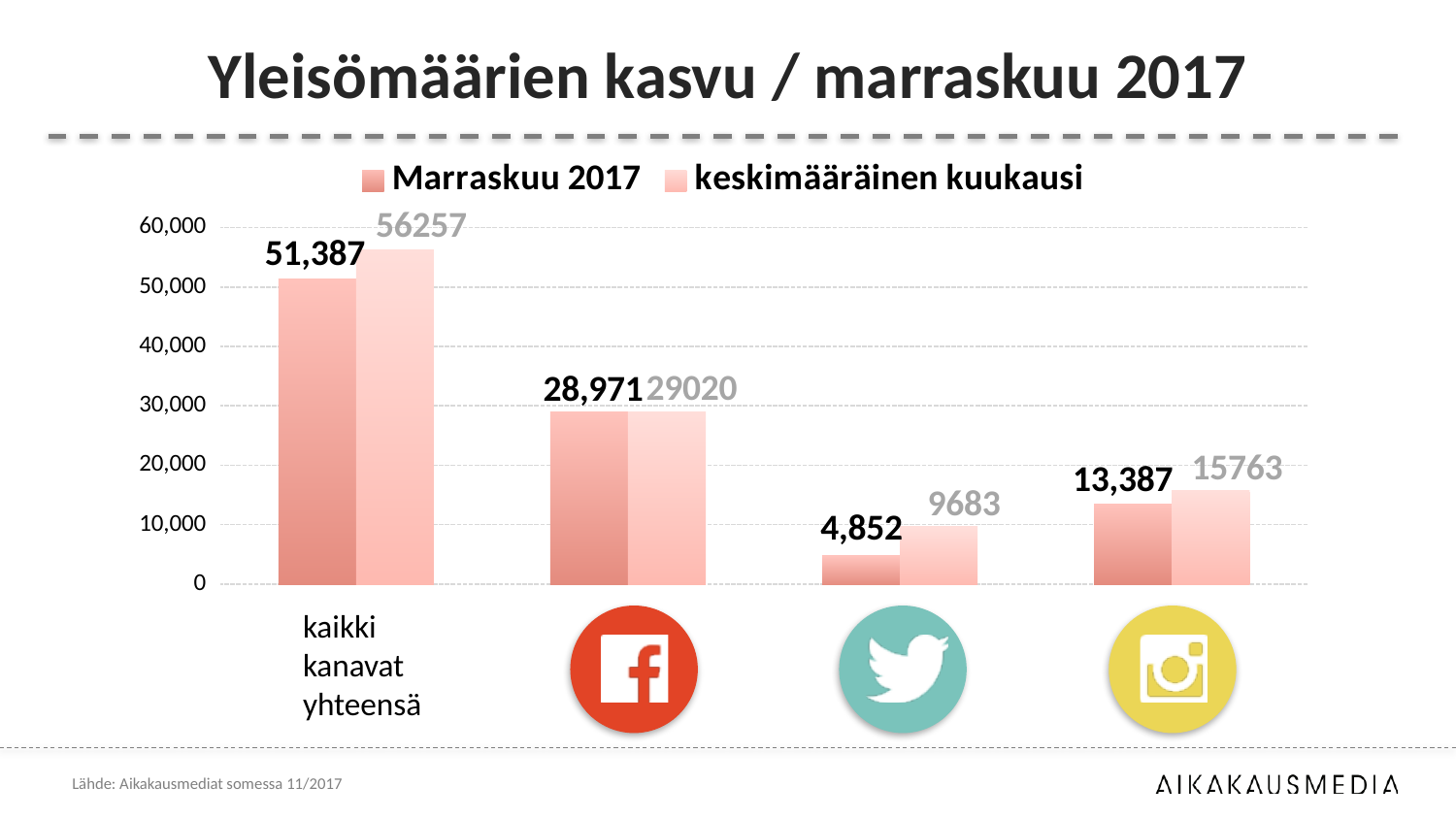
What kind of chart is shown on the slide? Bar chart What is the keskimääräinen kuukausi value for the fourth category (Instagram icon)? 15763 For the second category (Facebook icon), which is larger: the Marraskuu 2017 value or the keskimääräinen kuukausi value? keskimääräinen kuukausi For kaikki kanavat yhteensä, what is the difference between the keskimääräinen kuukausi value and the Marraskuu 2017 value? 4,870 What is the Marraskuu 2017 value for the third category (Twitter icon)? 4,852 Which category has the lowest Marraskuu 2017 value? The third category (Twitter icon) Which category has the highest Marraskuu 2017 value? kaikki kanavat yhteensä What is the title of the slide? Yleisömäärien kasvu / marraskuu 2017 How many series does the legend list? 2 How many categories are shown on the x axis? 4 What is the keskimääräinen kuukausi value for kaikki kanavat yhteensä? 56257 What is the Marraskuu 2017 value for kaikki kanavat yhteensä? 51,387